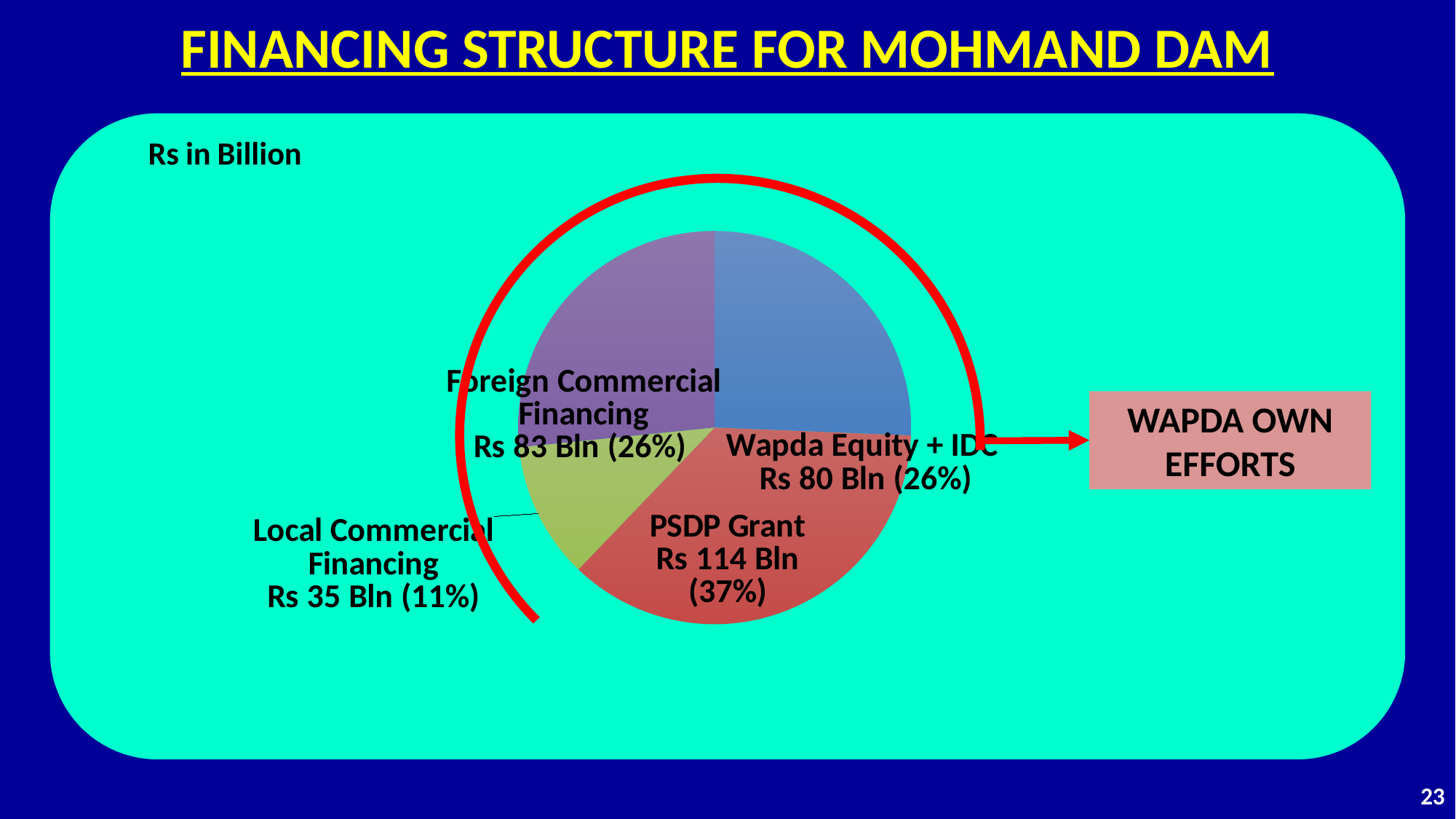
What is the total of all four financing sources shown in the pie chart? Rs 312 Bln Which is larger, Foreign Commercial Financing or Wapda Equity + IDC? Foreign Commercial Financing What is the title of the slide containing the pie chart? FINANCING STRUCTURE FOR MOHMAND DAM What type of chart is shown on the slide? pie chart What is the value for Wapda Equity + IDC? Rs 80 Bln Which financing source is the largest? PSDP Grant What is the value for PSDP Grant? Rs 114 Bln What share of the pie does Foreign Commercial Financing represent? 26% How many slices does the pie chart have? 4 What is the value for Local Commercial Financing? Rs 35 Bln What is the difference between PSDP Grant and Local Commercial Financing? Rs 79 Bln Which financing source is the smallest? Local Commercial Financing